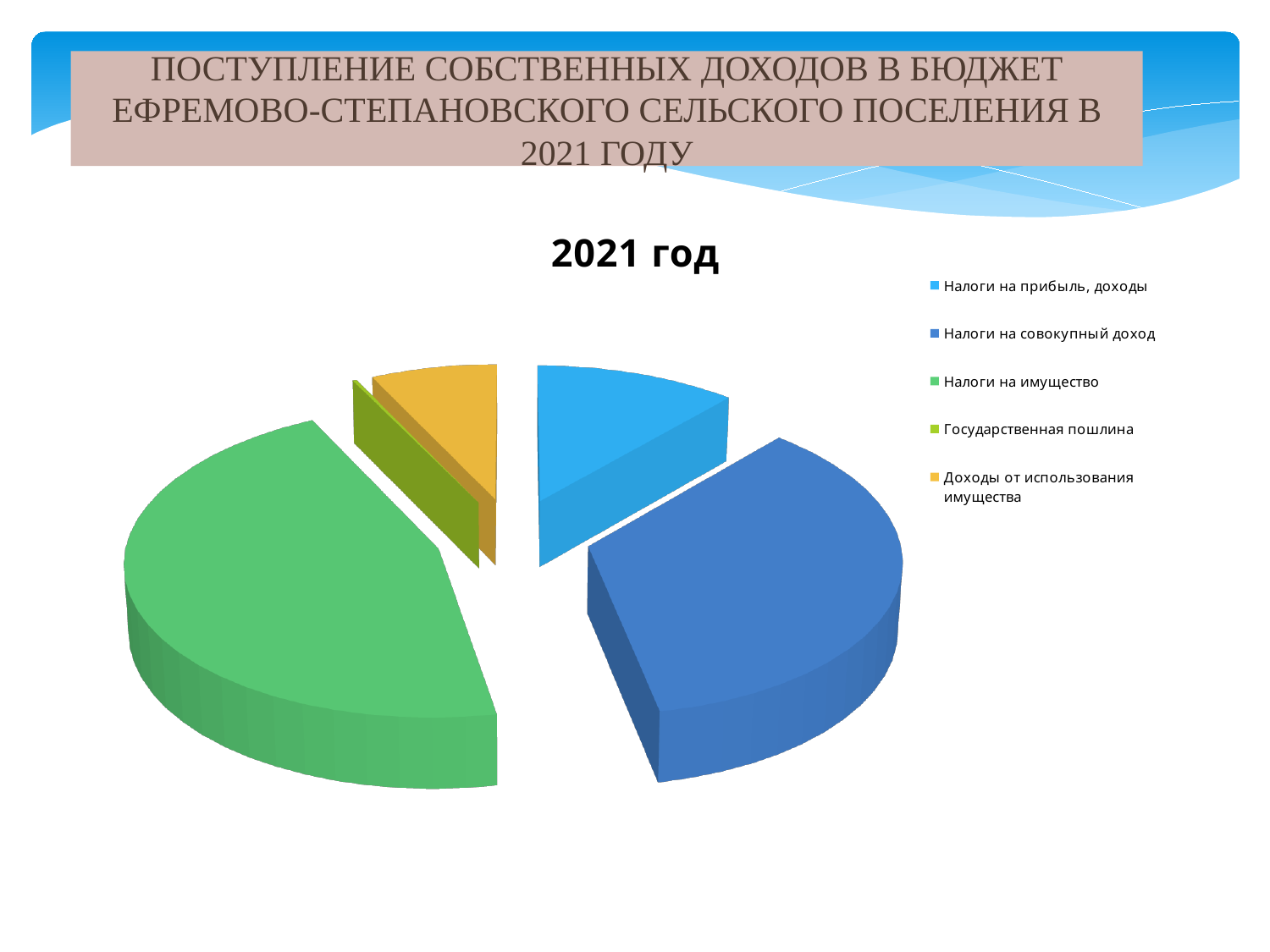
Which slice is larger: Налоги на имущество or Налоги на совокупный доход? Налоги на имущество Which slice is larger: Доходы от использования имущества or Государственная пошлина? Доходы от использования имущества Which category has the smallest slice of the pie? Государственная пошлина What colour is the slice for Налоги на имущество? green What kind of chart is shown on the slide? pie chart Which category has the largest slice of the pie? Налоги на имущество What is the title of the chart? 2021 год How many categories does the legend of the pie chart list? 5 Which slice is larger: Налоги на прибыль, доходы or Доходы от использования имущества? Налоги на прибыль, доходы